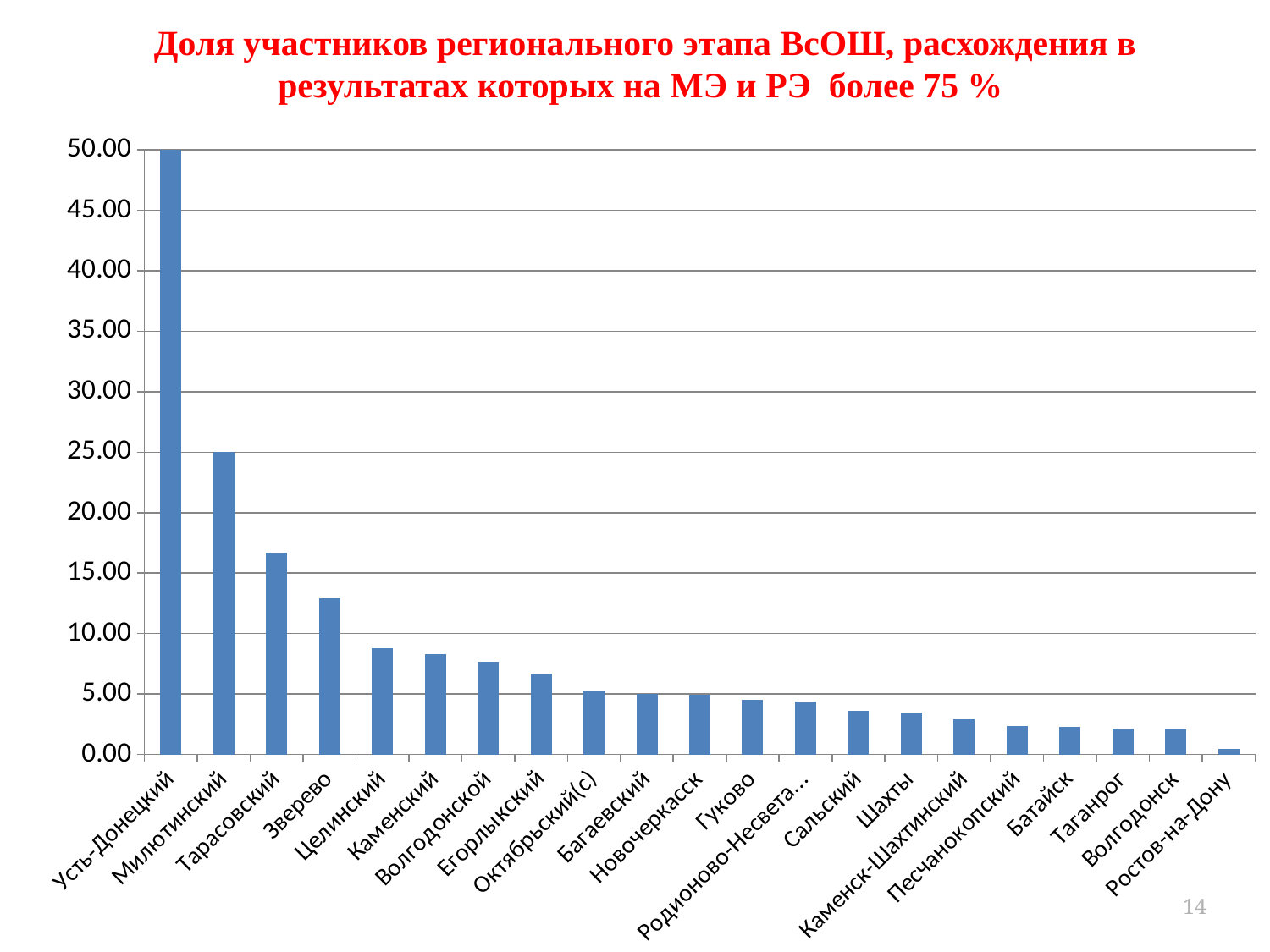
Which is larger, the value for Каменский or the value for Шахты? Каменский Is the value for Тарасовский greater or less than 15.00? greater Is the value for Зверево greater or less than 15.00? less How many categories (municipalities) are plotted on the x axis? 21 What is the highest tick value shown on the vertical axis? 50.00 What is the value for Усть-Донецкий? 50.00 Which category has the lowest value? Ростов-на-Дону Is the value for Целинский greater or less than 10.00? less Which category has the highest value? Усть-Донецкий What kind of chart is shown on the slide? bar chart What is the value for Милютинский? 25.00 Do the values rise or fall moving from left to right along the x axis? fall